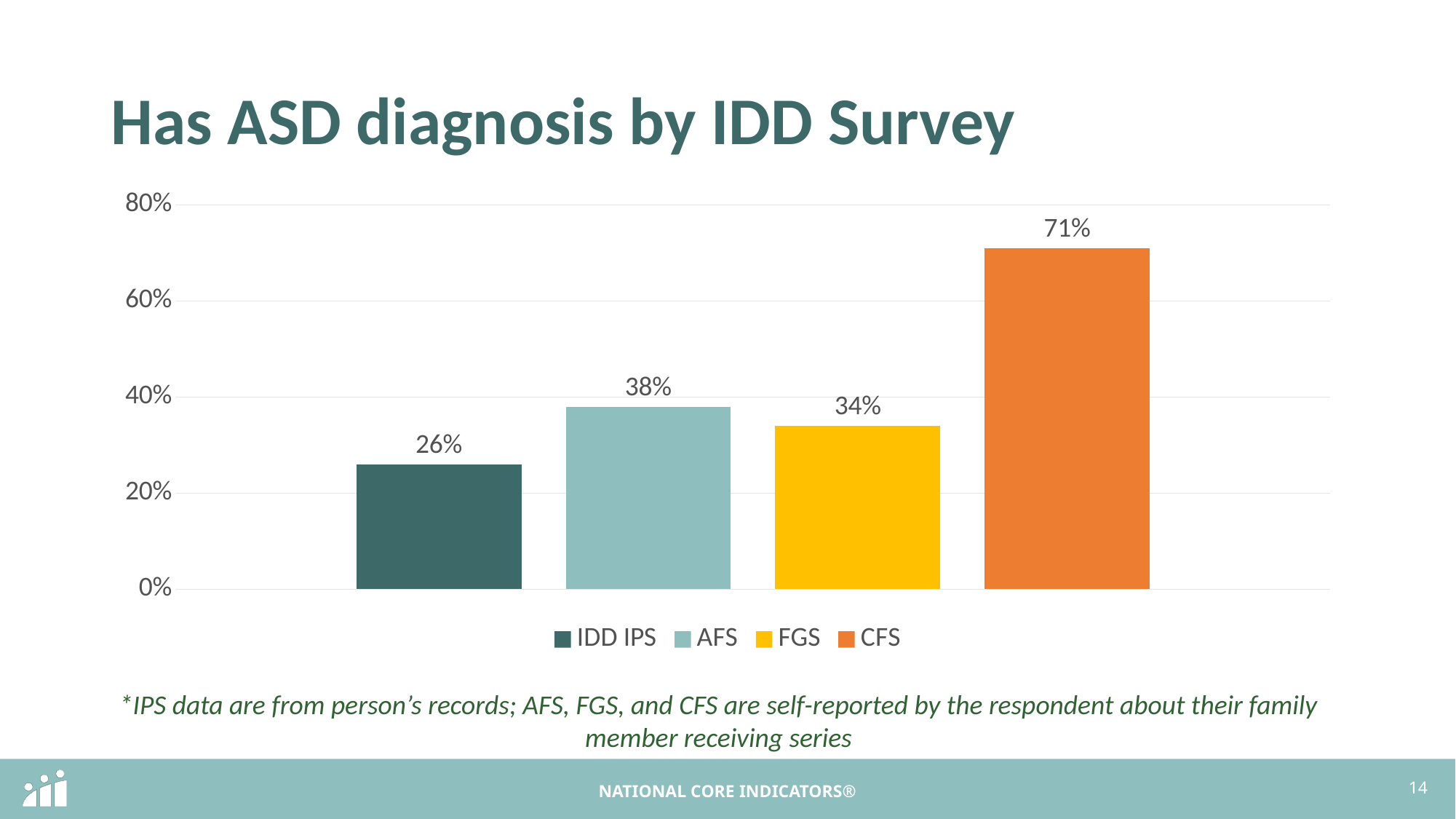
What is the difference between the AFS value and the FGS value? 4% What is the value for CFS? 71% What is the difference between the CFS value and the IDD IPS value? 45% How many series does the legend list? 4 Which is larger, the value for AFS or the value for FGS? AFS Which survey has the lowest percentage with an ASD diagnosis? IDD IPS What is the title of the chart? Has ASD diagnosis by IDD Survey What is the value for FGS? 34% Which survey has the highest percentage with an ASD diagnosis? CFS What is the value for AFS? 38% What kind of chart is shown on the slide? Bar chart What is the value for IDD IPS? 26%